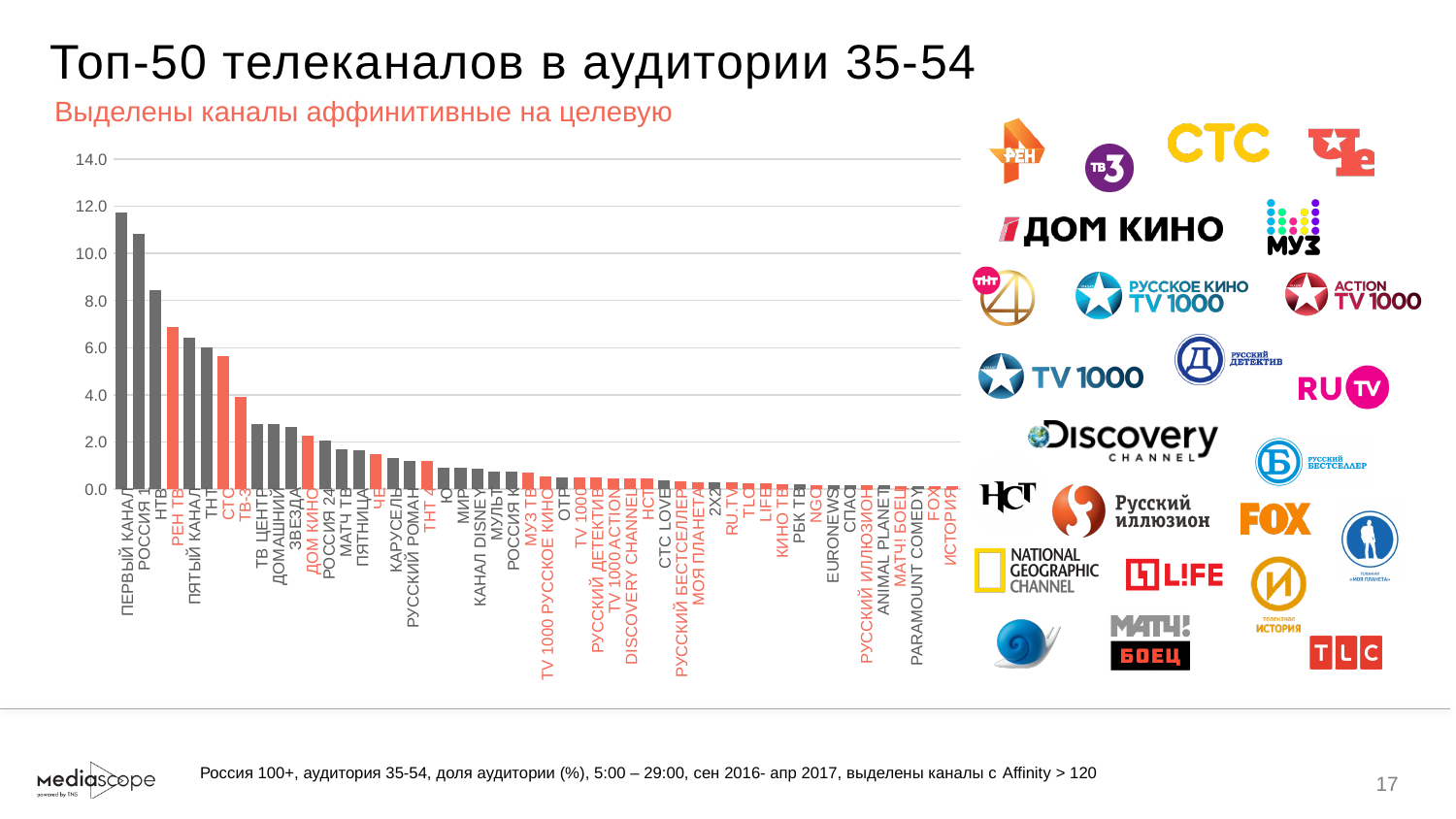
Do the values rise or fall moving from left to right along the x axis? fall What is the title of the slide containing the chart? Топ-50 телеканалов в аудитории 35-54 Which channel has the highest value in the chart? ПЕРВЫЙ КАНАЛ How many channels are plotted in the chart? 50 Is the value for ПЕРВЫЙ КАНАЛ greater or less than 10.0? greater Which has a larger value, ПЕРВЫЙ КАНАЛ or НТВ? ПЕРВЫЙ КАНАЛ Is the value for ТВ ЦЕНТР greater or less than 2.0? greater Which has a larger value, РЕН ТВ or ТВ3? РЕН ТВ Is the value for СТС greater or less than 8.0? less What kind of chart is shown on the slide? bar chart